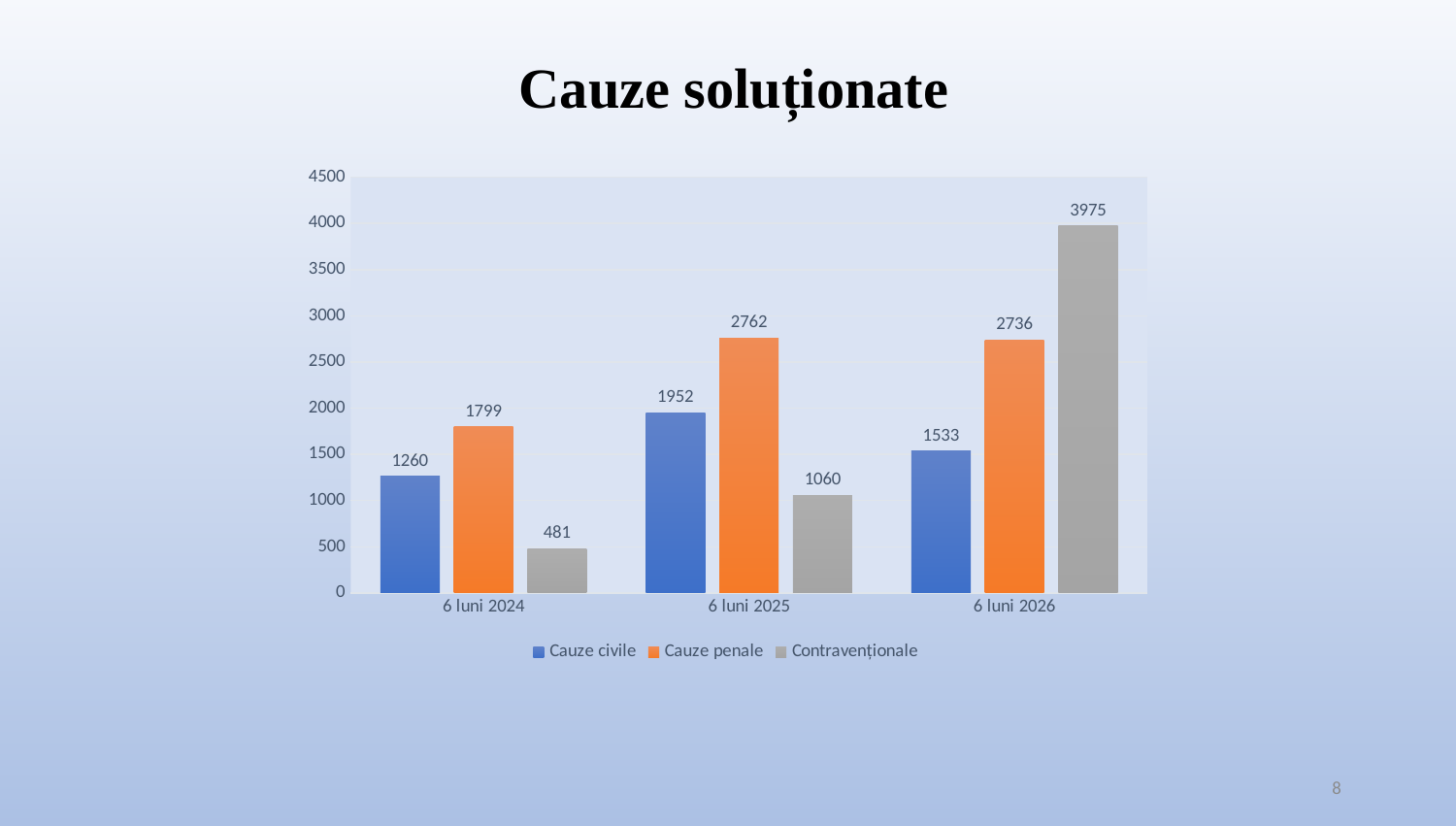
What is the value for Cauze penale in 6 luni 2026? 2736 Which category has the highest value for Contravenționale? 6 luni 2026 Which category has the lowest value for Cauze civile? 6 luni 2024 Do the values for Contravenționale rise or fall from 6 luni 2024 to 6 luni 2026? rise What is the value for Cauze civile in 6 luni 2025? 1952 What is the title of the chart? Cauze soluționate How many series does the legend list? 3 Which is larger: Cauze civile in 6 luni 2026 or Cauze civile in 6 luni 2025? 6 luni 2025 What is the value for Contravenționale in 6 luni 2024? 481 What kind of chart is shown on the slide? bar chart How many categories are shown on the x axis? 3 What is the difference between Cauze penale in 6 luni 2025 and 6 luni 2024? 963